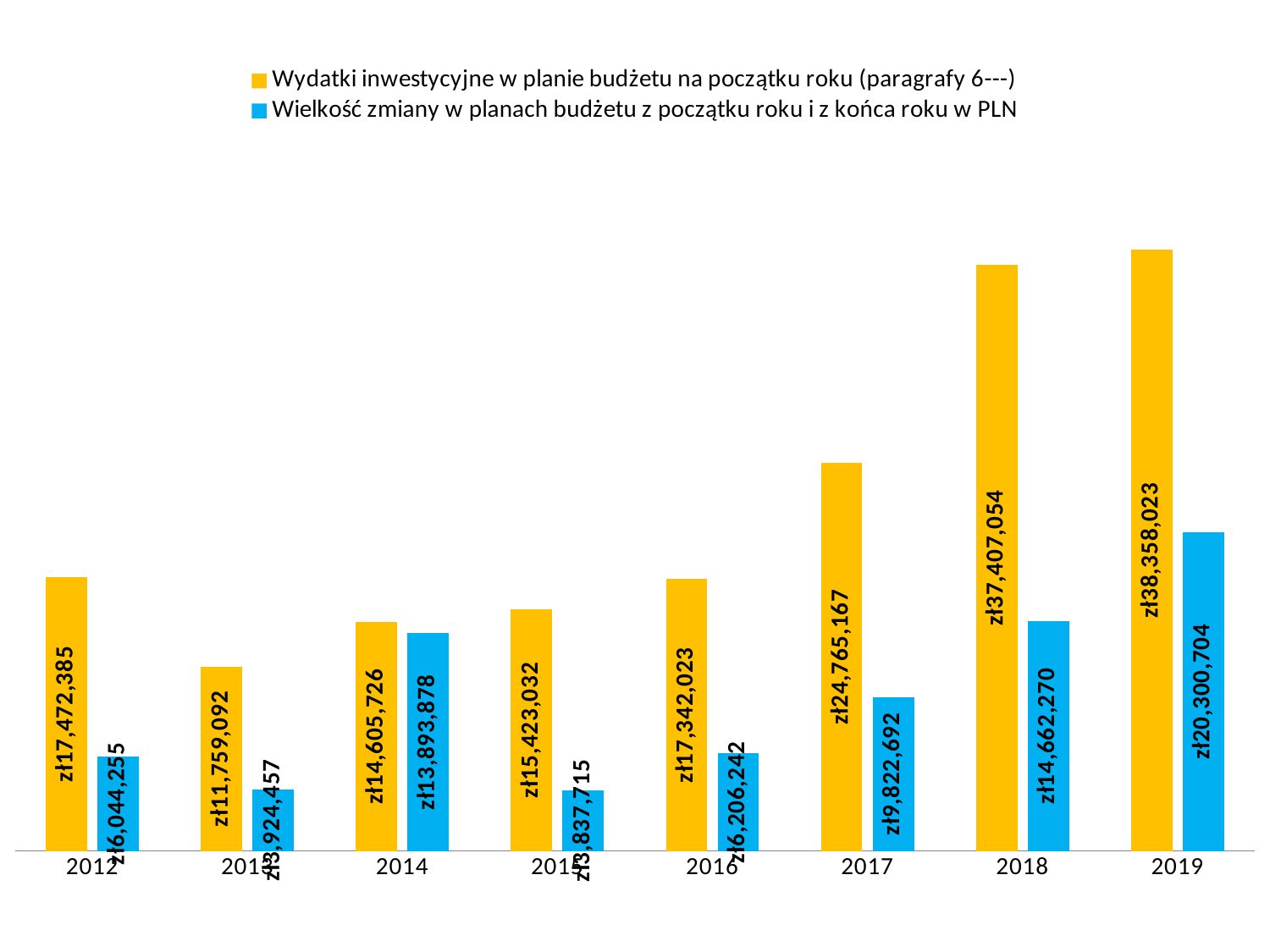
What type of chart is shown on the slide? Bar chart What is the value of the yellow series (Wydatki inwestycyjne w planie budżetu na początku roku) for 2017? zł24,765,167 Which year has the highest value for the yellow series (Wydatki inwestycyjne w planie budżetu na początku roku)? 2019 How many years are shown on the x axis? 8 Which is larger in 2014: the yellow series value or the blue series value? The yellow series (zł14,605,726) What is the difference between the yellow and blue values for 2019? zł18,057,319 What is the value of the yellow series for 2013? zł11,759,092 Which year has the lowest value for the yellow series (Wydatki inwestycyjne w planie budżetu na początku roku)? 2013 What is the value of the blue series for 2019? zł20,300,704 Which year has the highest value for the blue series (Wielkość zmiany w planach budżetu)? 2019 What is the value of the blue series (Wielkość zmiany w planach budżetu) for 2014? zł13,893,878 How many series does the legend list? 2